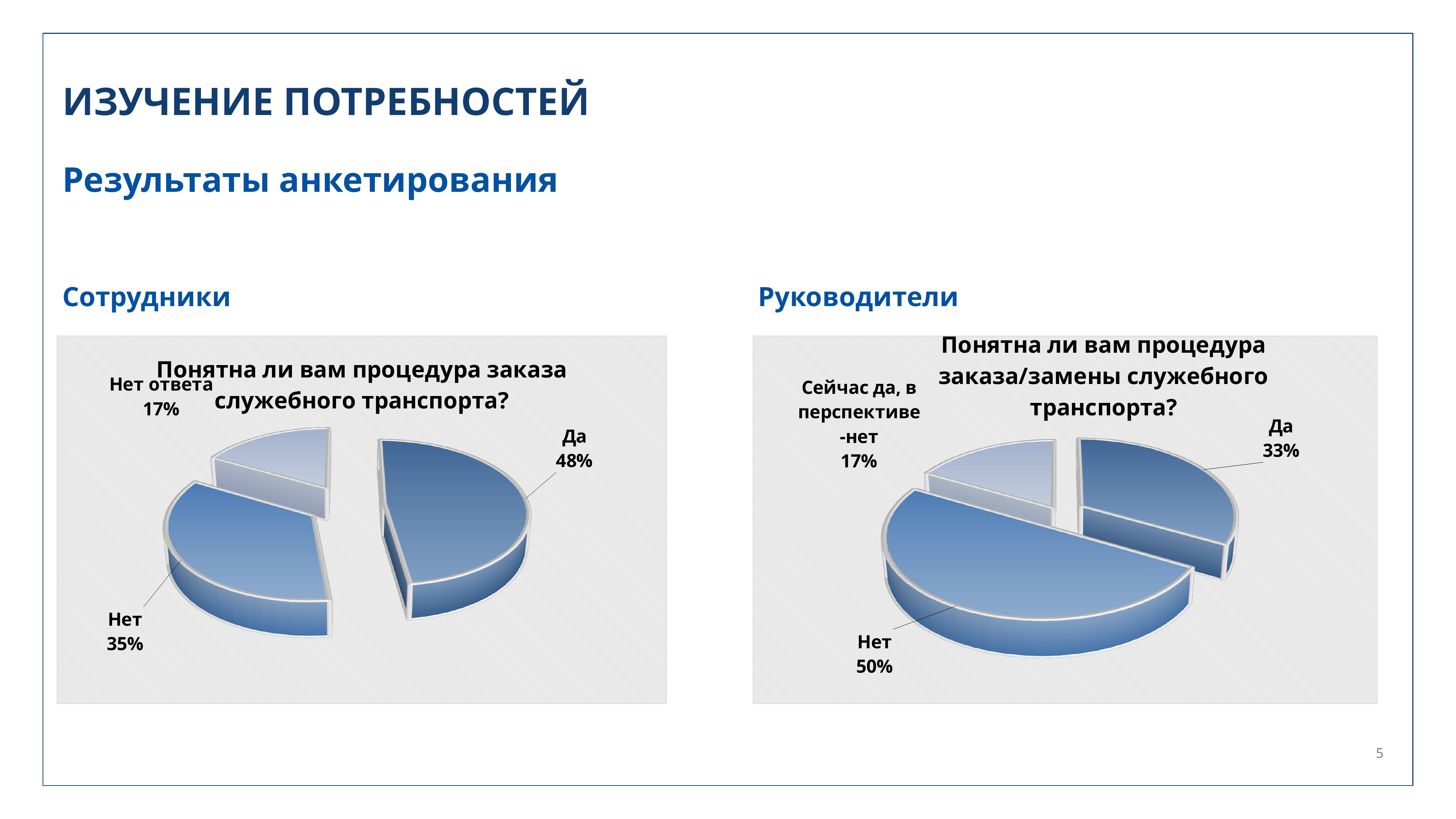
In the left chart (Сотрудники), what is the difference between the "Да" and "Нет" shares? 13% In the right chart (Руководители), what share is labelled "Сейчас да, в перспективе -нет"? 17% In the right chart (Руководители), which answer has the smallest share? Сейчас да, в перспективе -нет In the left chart (Сотрудники), which answer has the largest share? Да In the left chart (Сотрудники), what share of respondents answered "Да"? 48% Which is larger in the right chart (Руководители): the share for "Да" or the share for "Нет"? Нет In the right chart (Руководители), what share of respondents answered "Нет"? 50% In the left chart (Сотрудники), what share of respondents answered "Нет"? 35% How many slices does the left chart (Сотрудники) have? 3 What type of chart is used on the right (Руководители)? Pie chart In the right chart (Руководители), what share of respondents answered "Да"? 33% In the left chart (Сотрудники), what share is labelled "Нет ответа"? 17%